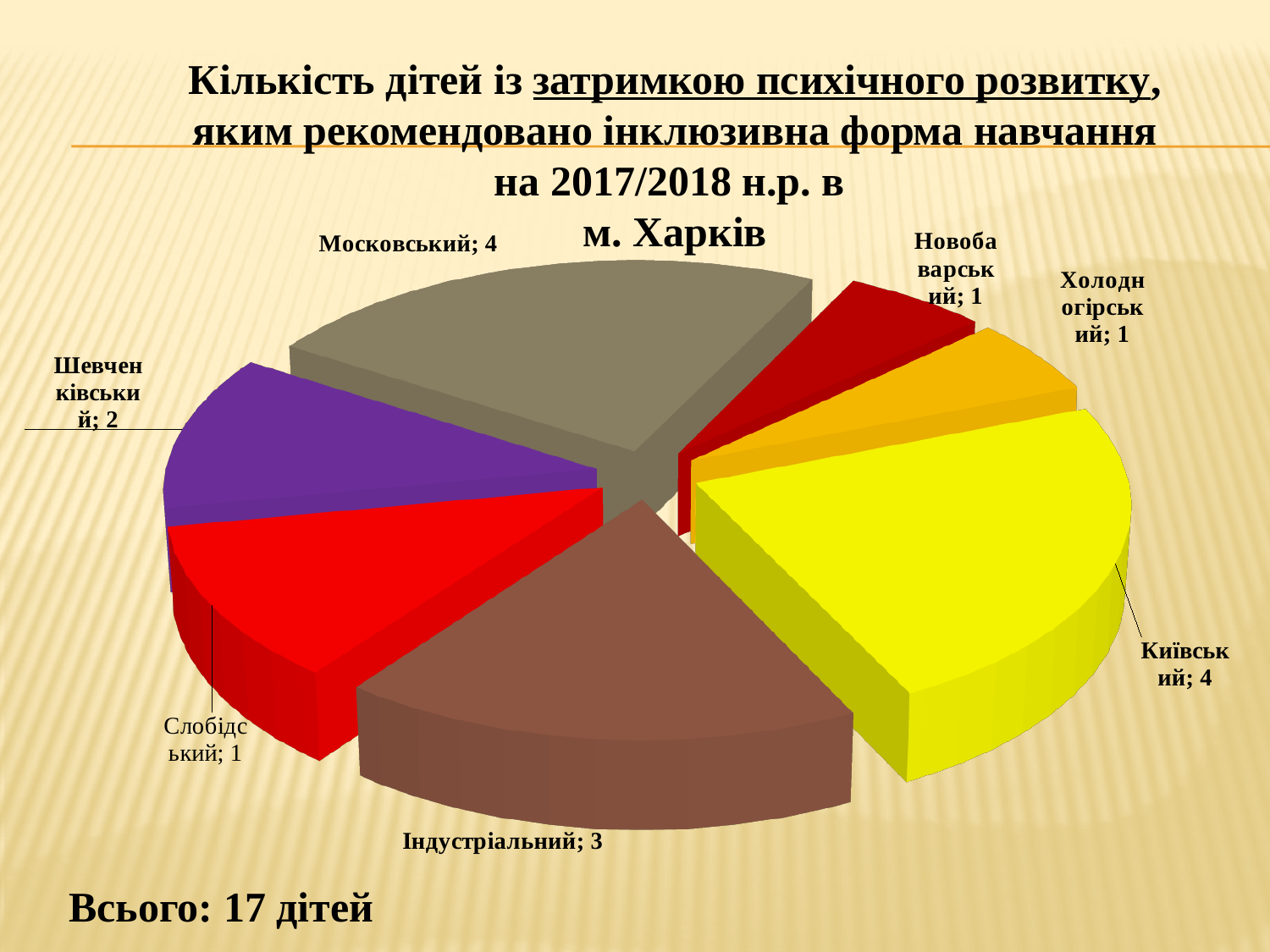
Which is larger, the value for Шевченківський or the value for Новобаварський? Шевченківський What is the value for Київський? 4 What is the difference between the values for Московський and Шевченківський? 2 How many labelled slices does the pie chart have? 7 What is the value for Московський? 4 What kind of chart is shown on the slide? pie chart What is the value for Шевченківський? 2 What total number of children is stated at the bottom of the slide? 17 дітей Which is larger, the value for Київський or the value for Індустріальний? Київський What is the value for Індустріальний? 3 What is the value for Слобідський? 1 What is the value for Холодногірський? 1